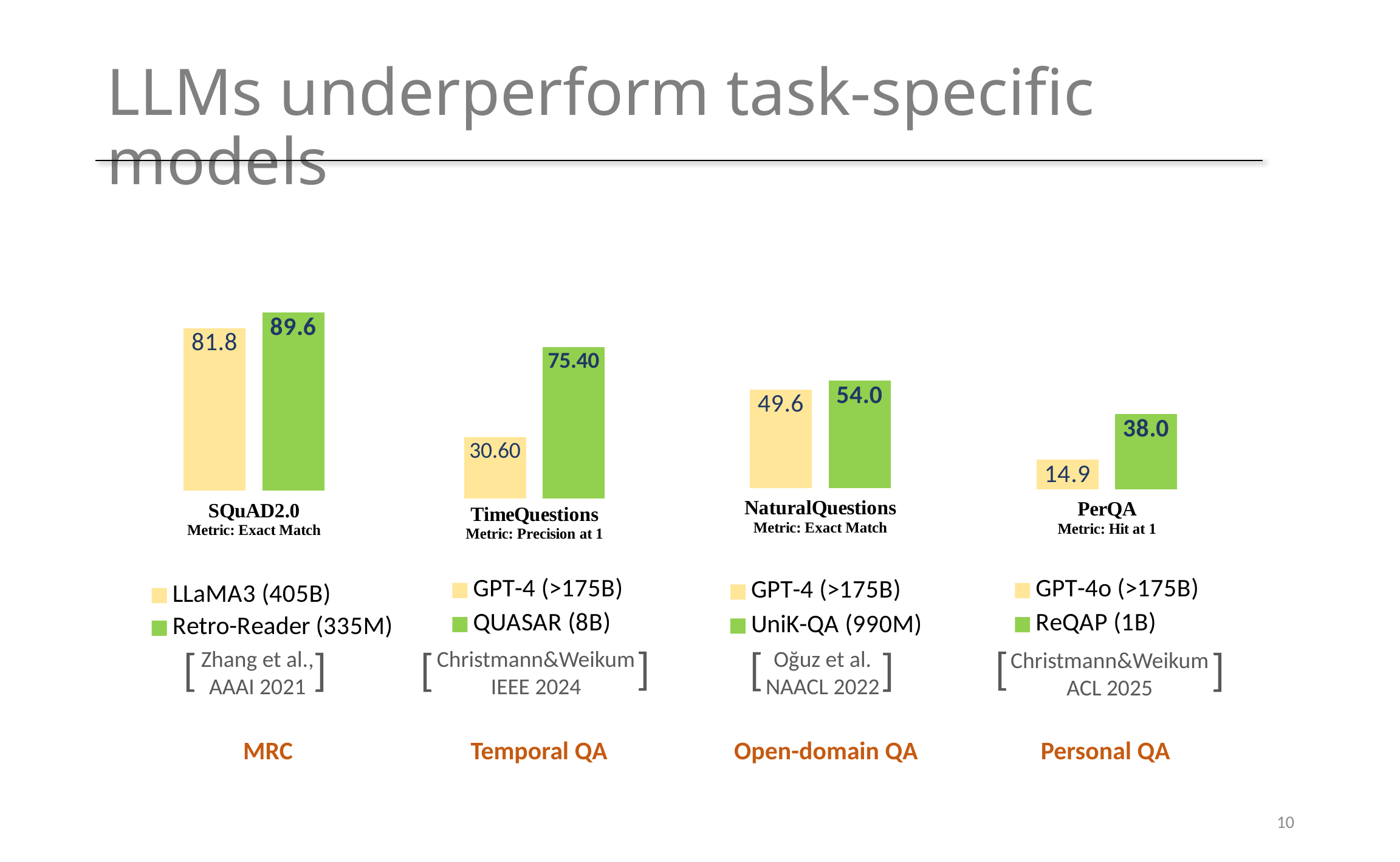
In the TimeQuestions chart, which bar is higher, GPT-4 (>175B) or QUASAR (8B)? QUASAR (8B) What kind of chart is the NaturalQuestions chart? Bar chart In the TimeQuestions chart, what is the value for QUASAR (8B)? 75.40 In the SQuAD2.0 chart, what is the value for LLaMA3 (405B)? 81.8 In the PerQA chart, what is the difference between ReQAP (1B) and GPT-4o (>175B)? 23.1 In the TimeQuestions chart, what is the value for GPT-4 (>175B)? 30.60 How many series does the legend of the SQuAD2.0 chart list? 2 In the SQuAD2.0 chart, what is the value for Retro-Reader (335M)? 89.6 In the NaturalQuestions chart, what is the value for UniK-QA (990M)? 54.0 In the PerQA chart, what is the value for GPT-4o (>175B)? 14.9 What metric is used in the PerQA chart? Hit at 1 In the NaturalQuestions chart, what is the difference between UniK-QA (990M) and GPT-4 (>175B)? 4.4